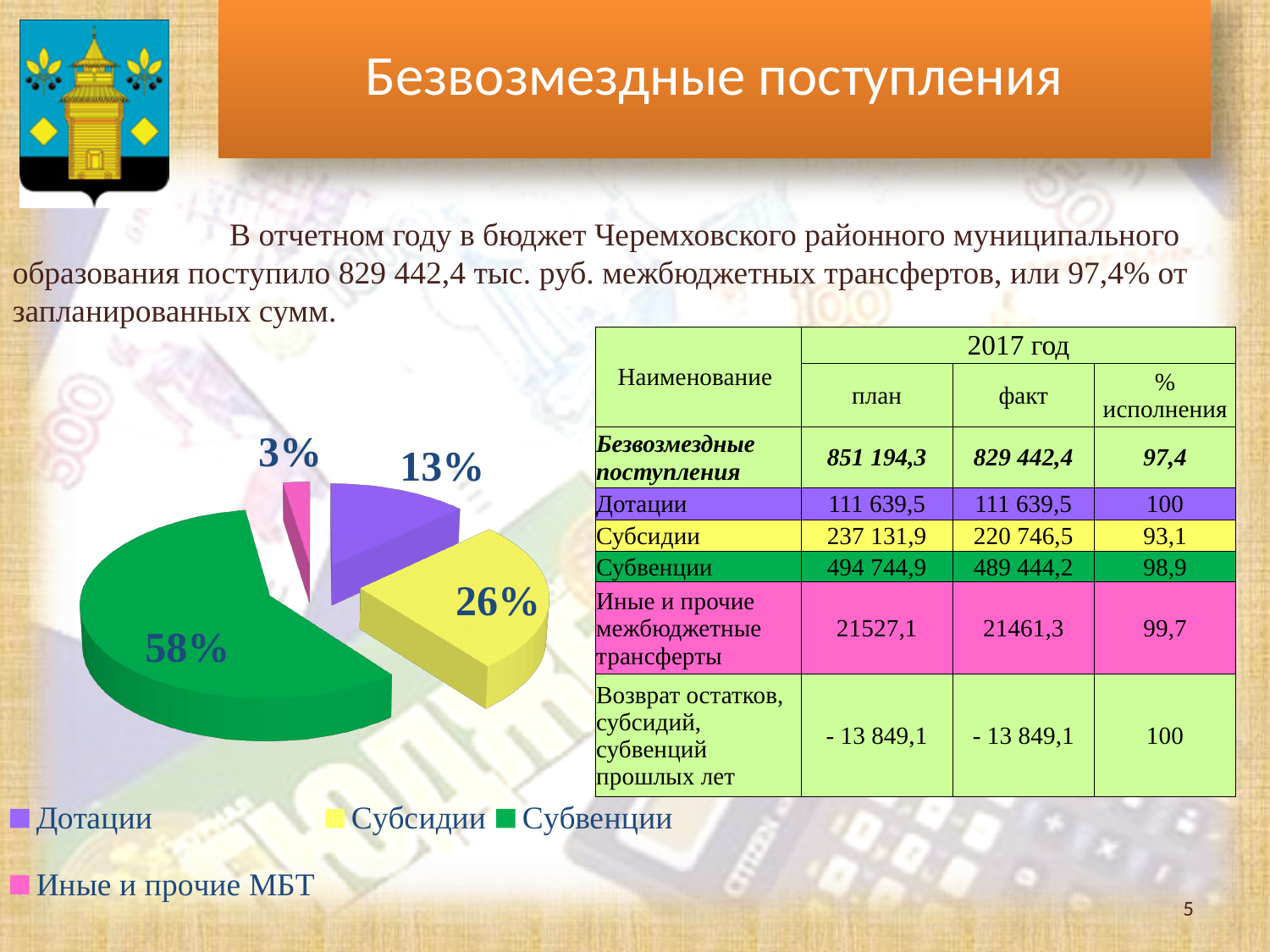
How many slices does the pie chart have? 4 Which category has the smallest slice of the pie? Иные и прочие МБТ How many entries does the legend list? 4 What share of the pie does Субсидии have? 26% What share of the pie does Дотации have? 13% Which slice is larger, Дотации or Субсидии? Субсидии What is the difference in percentage points between the Субвенции slice and the Субсидии slice? 32 What kind of chart is shown on the slide? Pie chart Which category has the largest slice of the pie? Субвенции What share of the pie does Иные и прочие МБТ have? 3% What share of the pie does Субвенции have? 58% What colour is the Субвенции slice in the pie chart? Green